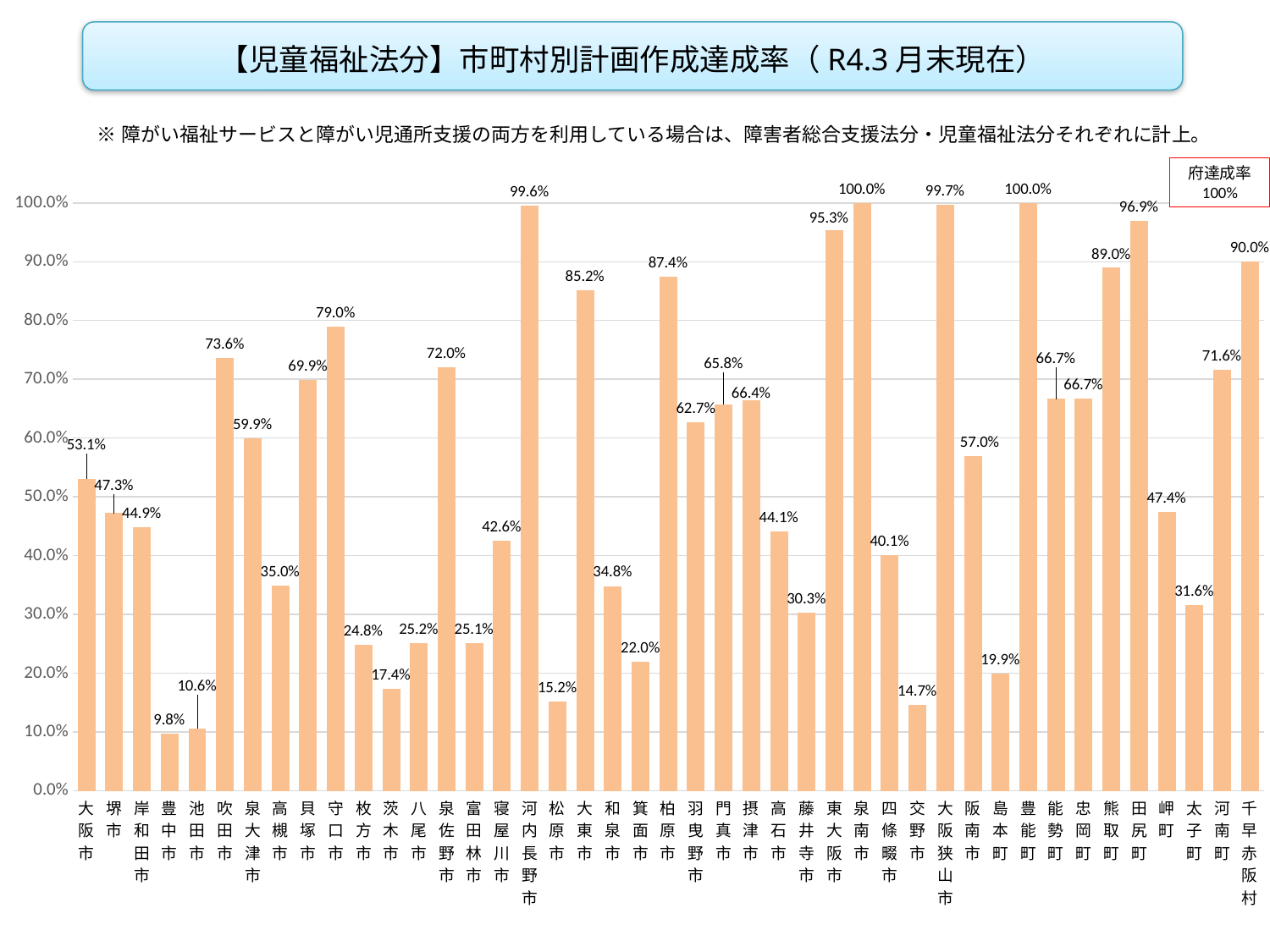
What kind of chart is shown on the slide? bar chart How many municipalities are shown on the x axis? 43 What is the difference between the values for 守口市 and 枚方市? 54.2% What is the value for 豊中市? 9.8% Which has a larger value, 大東市 or 柏原市? 柏原市 Is the value for 東大阪市 greater or less than 90.0%? greater What is the value for 河内長野市? 99.6% What is the value for 交野市? 14.7% What is the value for 千早赤阪村? 90.0% Which has a larger value, 吹田市 or 泉佐野市? 吹田市 Which municipality has the lowest value? 豊中市 What is the title of the chart? 【児童福祉法分】市町村別計画作成達成率（R4.3月末現在）